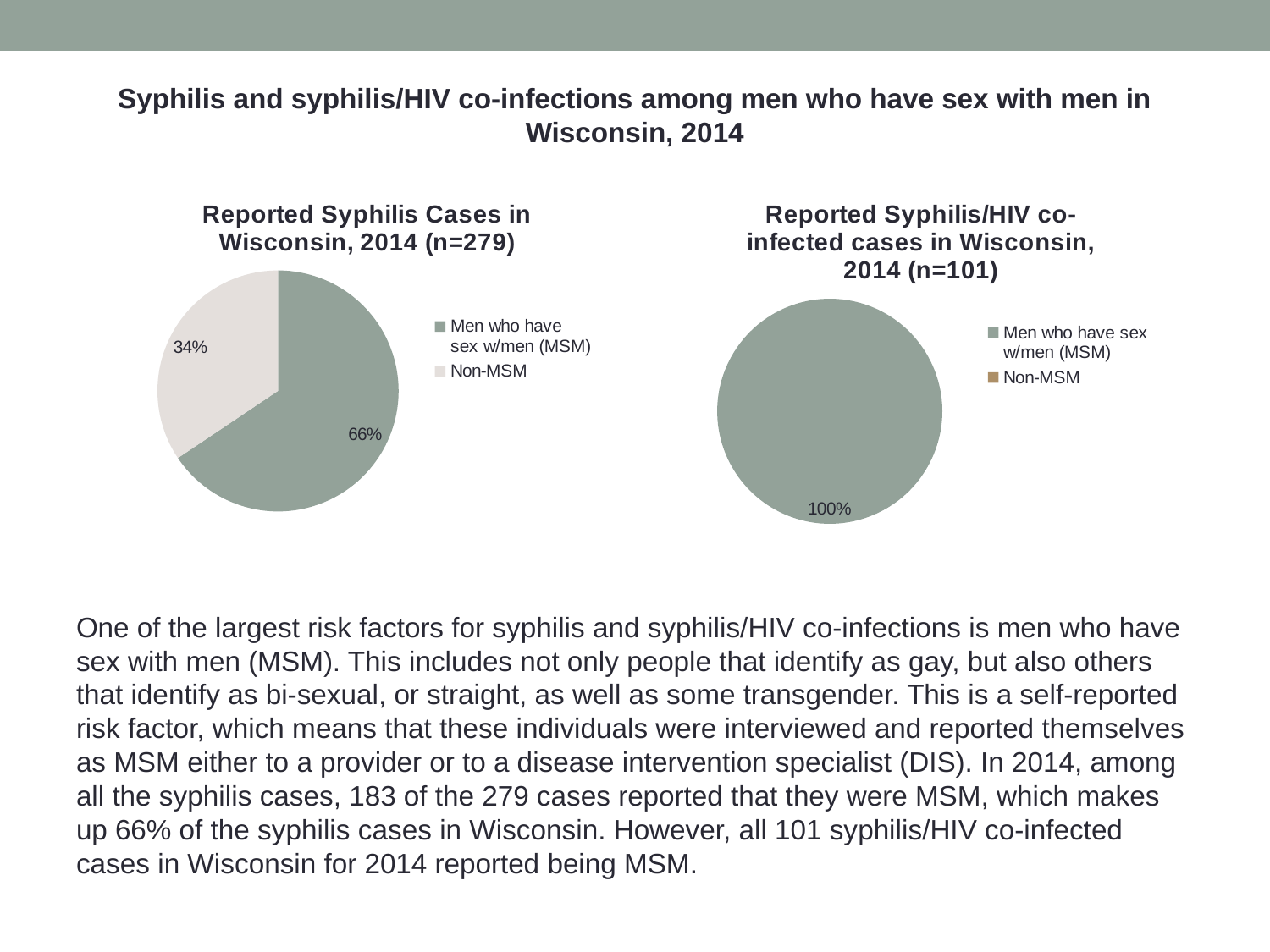
In the 'Reported Syphilis Cases in Wisconsin, 2014 (n=279)' chart, is the MSM slice larger or smaller than the Non-MSM slice? larger How many entries does the legend of the 'Reported Syphilis Cases in Wisconsin, 2014 (n=279)' chart list? 2 What is the title of the chart on the right of the slide? Reported Syphilis/HIV co-infected cases in Wisconsin, 2014 (n=101) In the 'Reported Syphilis Cases in Wisconsin, 2014 (n=279)' chart, what share of cases is labelled for men who have sex with men (MSM)? 66% In the 'Reported Syphilis Cases in Wisconsin, 2014 (n=279)' chart, what share of cases is labelled Non-MSM? 34% How many charts are shown on the slide? 2 In the 'Reported Syphilis Cases in Wisconsin, 2014 (n=279)' chart, what is the difference in percentage points between the MSM and Non-MSM slices? 32 What kind of chart is the 'Reported Syphilis Cases in Wisconsin, 2014 (n=279)' chart? pie chart In the 'Reported Syphilis Cases in Wisconsin, 2014 (n=279)' chart, which category has the smaller slice? Non-MSM In the 'Reported Syphilis Cases in Wisconsin, 2014 (n=279)' chart, which category has the larger slice? Men who have sex w/men (MSM) In the 'Reported Syphilis/HIV co-infected cases in Wisconsin, 2014 (n=101)' chart, what share is labelled for men who have sex with men (MSM)? 100% What kind of chart is the 'Reported Syphilis/HIV co-infected cases in Wisconsin, 2014 (n=101)' chart? pie chart